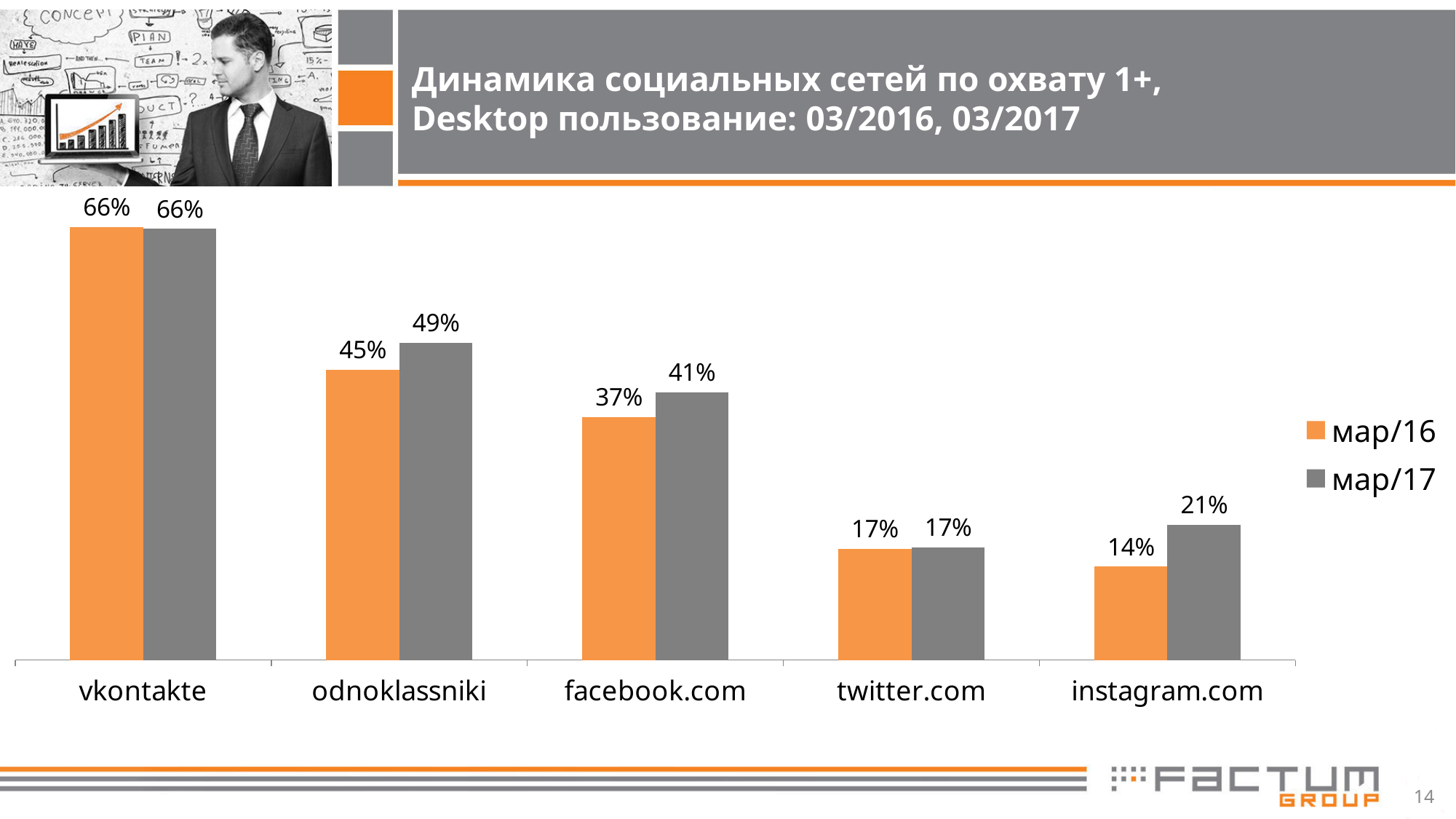
Which category has the highest value in the мар/16 series? vkontakte How many series does the legend list? 2 How many categories are shown on the x axis? 5 What is the value for odnoklassniki in the мар/17 series? 49% What kind of chart is shown on the slide? bar chart Which is larger: the мар/17 value for facebook.com or the мар/17 value for odnoklassniki? odnoklassniki Which category has the lowest value in the мар/16 series? instagram.com Which colour represents the мар/16 series in the legend? orange What is the value for instagram.com in the мар/16 series? 14% What is the difference between the мар/17 and мар/16 values for instagram.com? 7% What is the value for facebook.com in the мар/17 series? 41% What is the difference between the мар/17 and мар/16 values for odnoklassniki? 4%